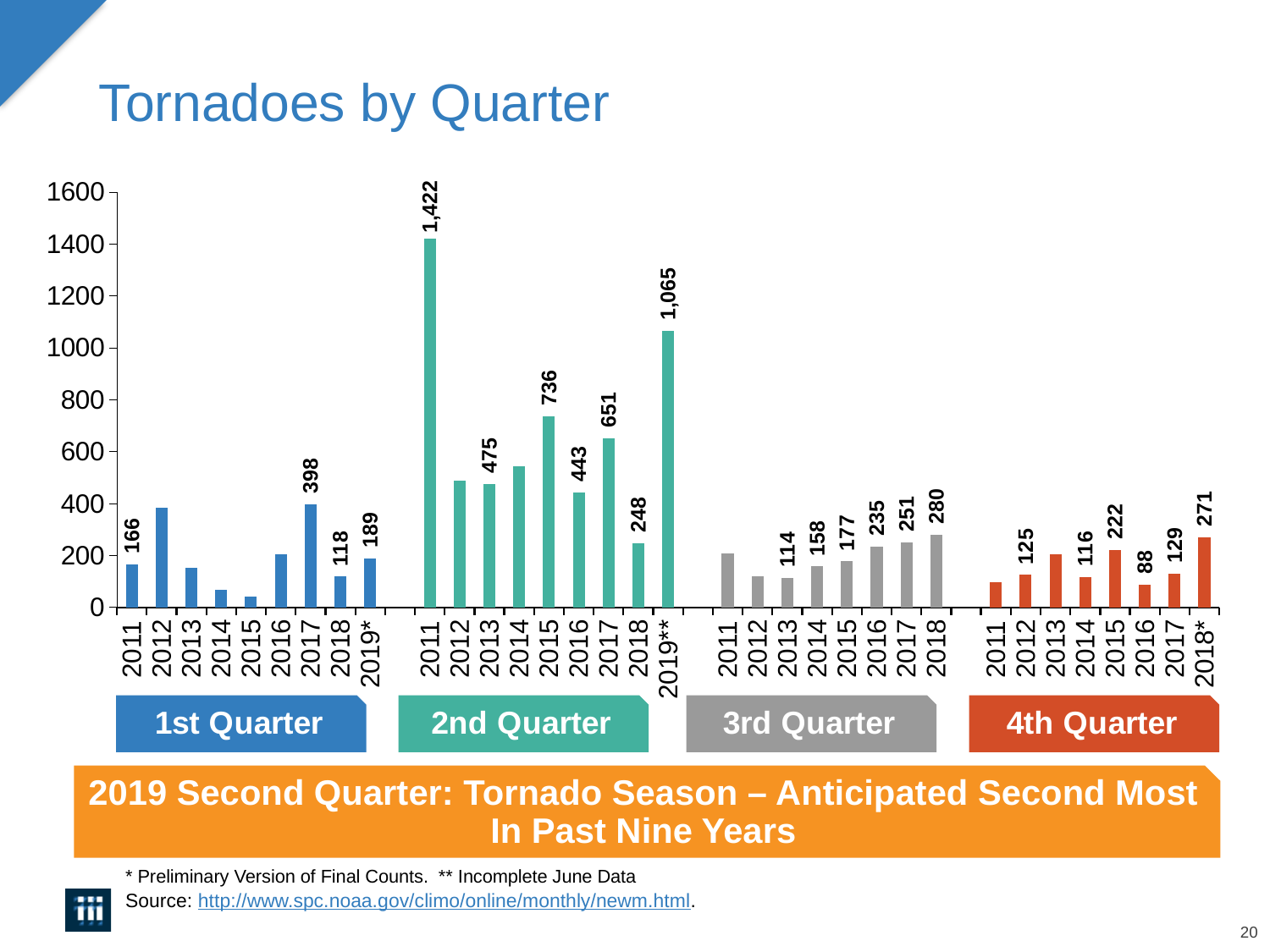
Which year has the highest bar in the 2nd Quarter group? 2011 What is the value shown for the 3rd Quarter of 2016? 235 How many tornadoes were recorded in the 2nd Quarter of 2011? 1,422 What kind of chart is shown on the slide? Bar chart How many years are shown in the 3rd Quarter group? 8 Which is larger, the 2nd Quarter value for 2015 or for 2017? 2015 Which year has the lowest labelled value in the 4th Quarter group? 2016 What is the value shown for the 4th Quarter of 2018*? 271 What is the difference between the 2nd Quarter values for 2011 and 2019**? 357 Is the value for the 1st Quarter of 2012 greater or less than 200? greater From 2013 to 2018, do the 3rd Quarter values rise or fall? Rise What is the value shown for the 1st Quarter of 2017? 398